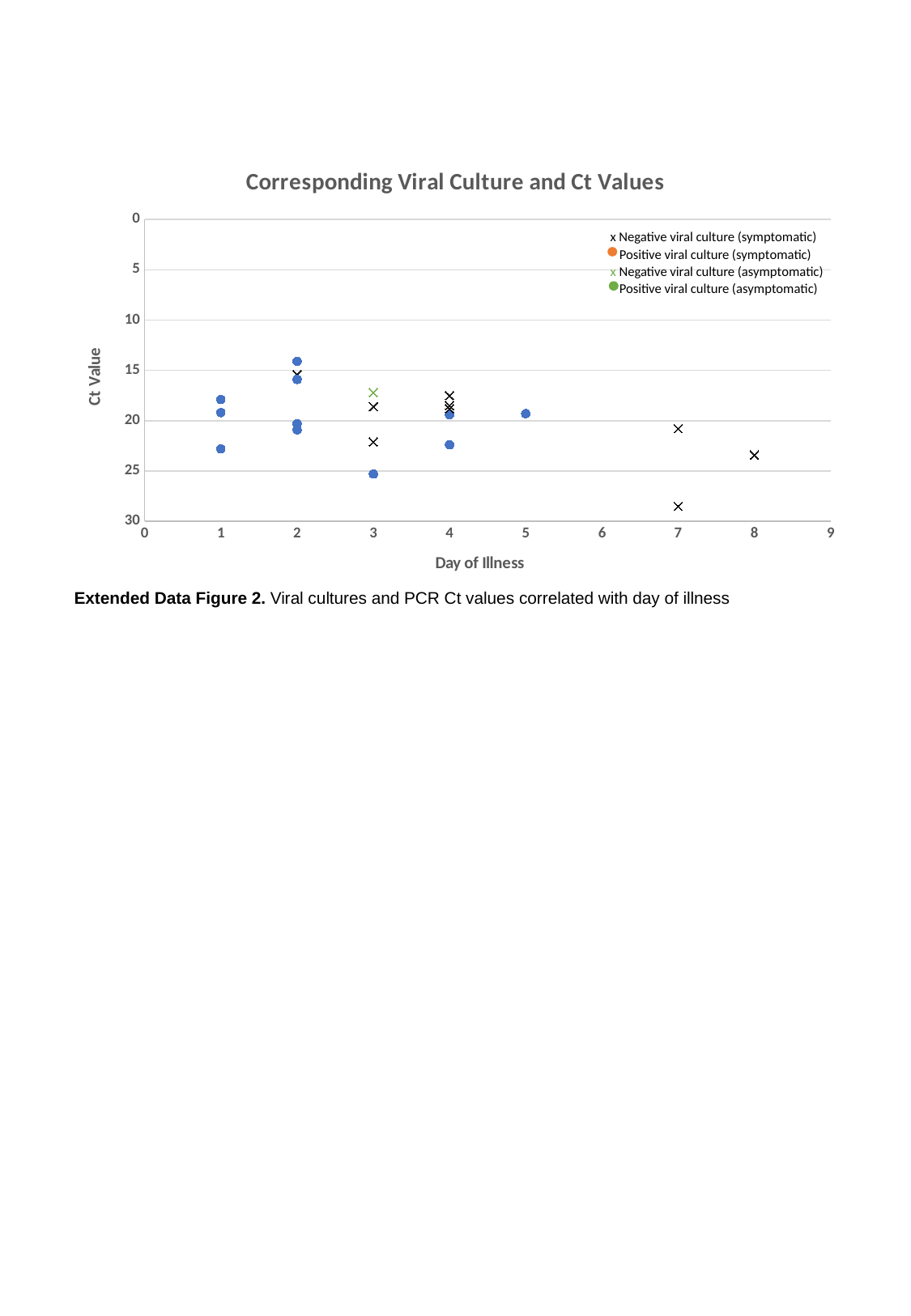
Is the Ct value of the highest positive viral culture point at day 2 greater or less than 15? less Is the Ct value of the green negative viral culture (asymptomatic) point at day 3 greater or less than 20? less How many series does the legend list? 4 What is the label of the x axis? Day of Illness What is the title of the chart? Corresponding Viral Culture and Ct Values How many data points are plotted at day 8? 1 What kind of chart is shown on the slide? scatter chart How many negative viral culture (asymptomatic) points are plotted on the chart? 1 Is the Ct value of the lowest positive viral culture point at day 1 greater or less than 20? greater How many negative viral culture (x) markers are plotted at day 7? 2